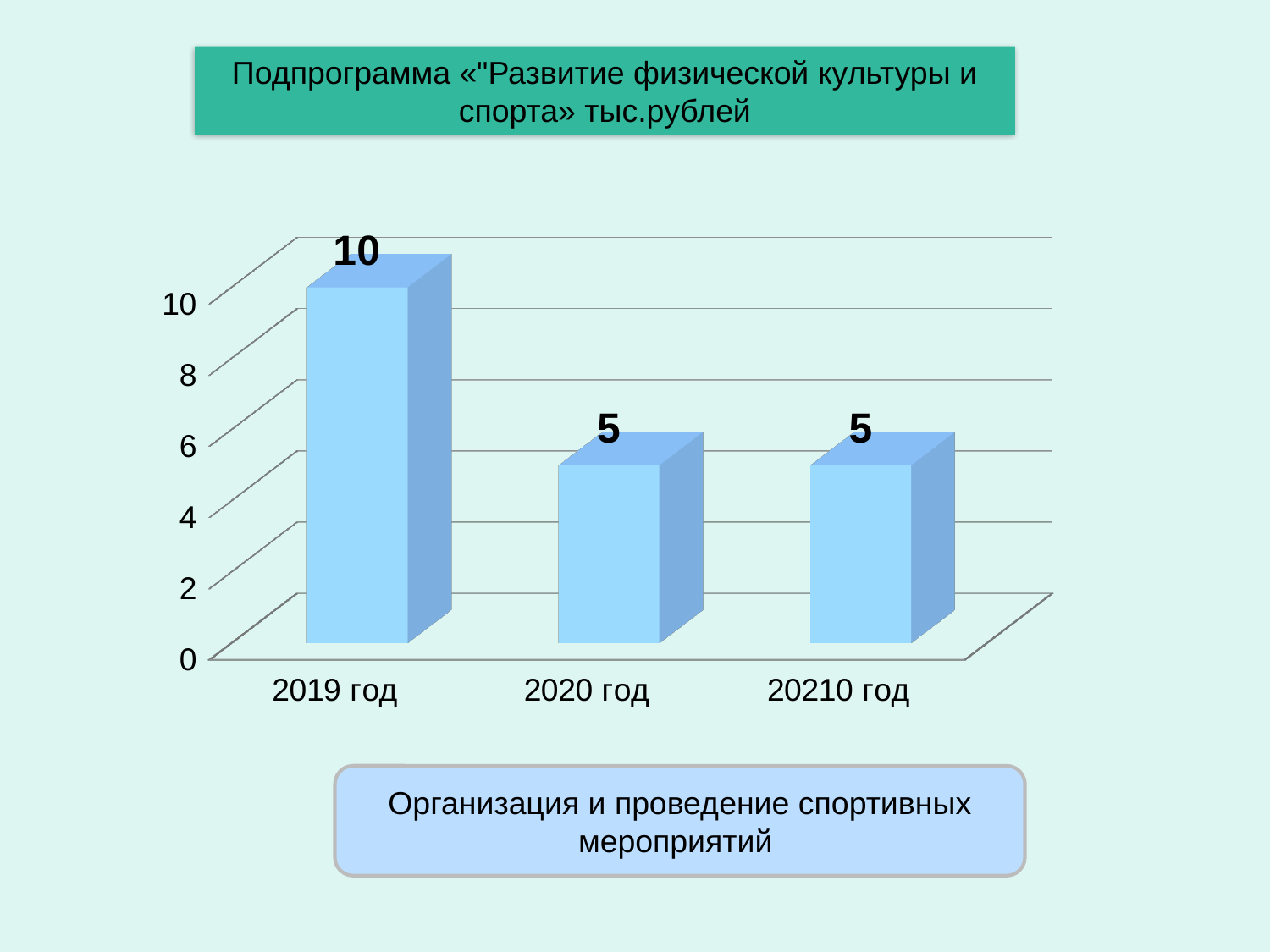
Is the value for 2020 год greater or less than 8? less What is the value for 2019 год? 10 What is the value for 2020 год? 5 What is the difference between the values for 2019 год and 2020 год? 5 How many categories are shown on the x axis? 3 Which is larger, the value for 2019 год or the value for 20210 год? 2019 год Do the values rise or fall from 2019 год to 2020 год? fall Which year has the highest value? 2019 год What is the highest tick value shown on the vertical axis? 10 What is the value for 20210 год? 5 What kind of chart is shown on the slide? bar chart What is the text in the box below the chart? Организация и проведение спортивных мероприятий